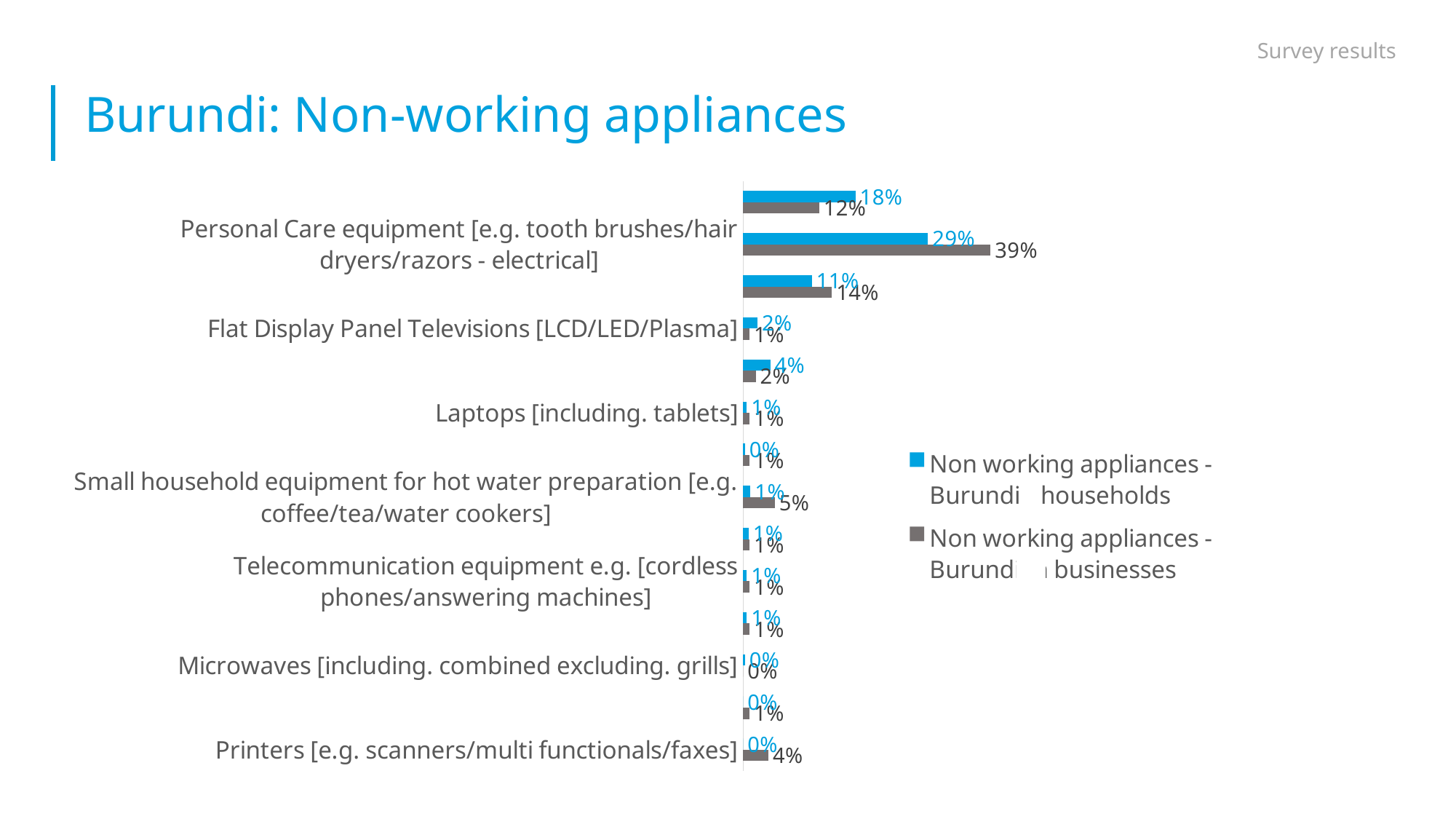
What is the value for Small household equipment for hot water preparation in the Burundi businesses series? 5% What is the value for Personal Care equipment in the 'Non working appliances - Burundi households' series? 29% What is the value for Personal Care equipment in the 'Non working appliances - Burundi businesses' series? 39% What is the difference between the Burundi businesses and Burundi households values for Printers? 4 percentage points What is the difference between the Burundi businesses and Burundi households values for Personal Care equipment? 10 percentage points How many series does the legend list? 2 What is the value for Printers [e.g. scanners/multi functionals/faxes] in the Burundi businesses series? 4% Which labelled category has the highest value in the Burundi businesses series? Personal Care equipment [e.g. tooth brushes/hair dryers/razors - electrical] What kind of chart is shown on the slide? Bar chart What is the value for Flat Display Panel Televisions [LCD/LED/Plasma] in the Burundi households series? 2% What is the value for Microwaves in the Burundi households series? 0% For Personal Care equipment, which series has the larger value: Burundi households or Burundi businesses? Burundi businesses